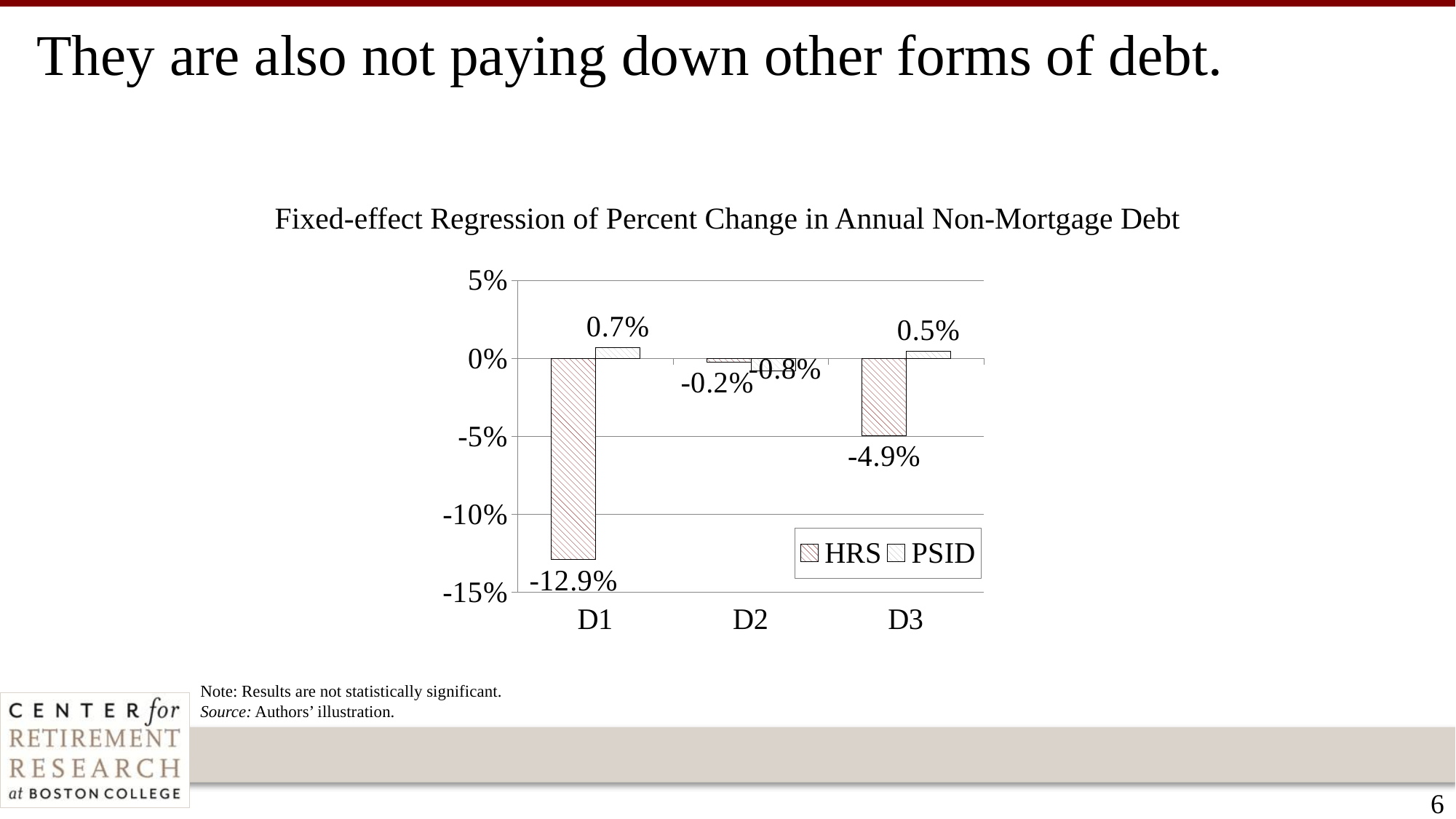
How many categories are shown on the x axis? 3 What is the PSID value for D1? 0.7% Which is larger, the PSID value for D1 or for D3? D1 What is the difference between the HRS values for D1 and D3? 8.0 percentage points Is the HRS value for D1 greater or less than -10%? less What kind of chart is shown on the slide? bar chart What is the HRS value for D1? -12.9% What is the HRS value for D3? -4.9% What is the title of the chart? Fixed-effect Regression of Percent Change in Annual Non-Mortgage Debt How many series does the legend list? 2 What is the PSID value for D3? 0.5% Which category has the lowest HRS value? D1